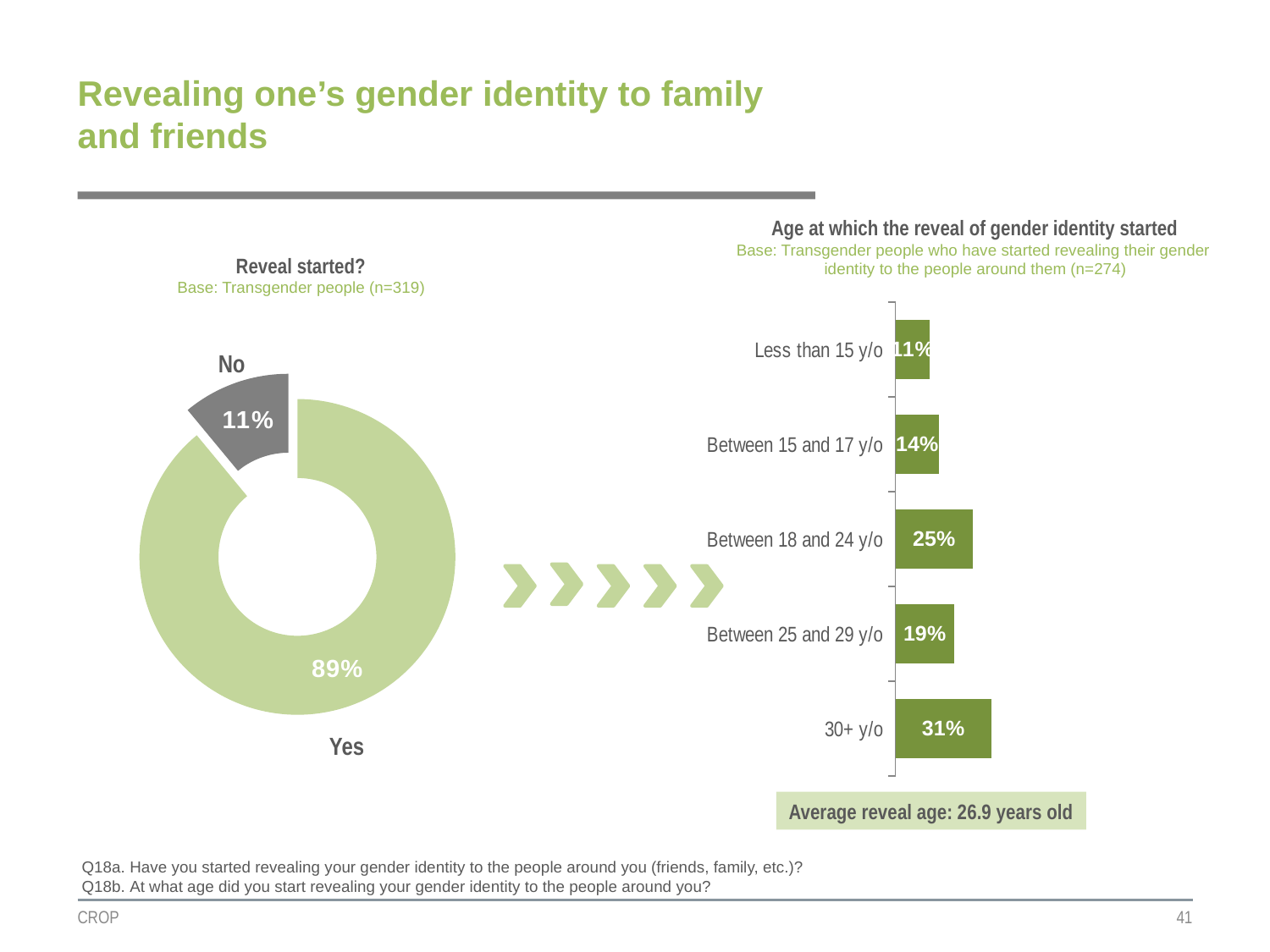
In the 'Age at which the reveal of gender identity started' chart, what is the value for Between 18 and 24 y/o? 25% In the 'Reveal started?' chart, how many categories are shown? 2 In the 'Age at which the reveal of gender identity started' chart, which age group has the highest value? 30+ y/o In the 'Reveal started?' chart, what percentage answered No? 11% In the 'Age at which the reveal of gender identity started' chart, what is the value for 30+ y/o? 31% In the 'Age at which the reveal of gender identity started' chart, which is larger: Between 18 and 24 y/o or Between 15 and 17 y/o? Between 18 and 24 y/o In the 'Age at which the reveal of gender identity started' chart, what is the difference between the values for 30+ y/o and Between 25 and 29 y/o? 12% In the 'Age at which the reveal of gender identity started' chart, which age group has the lowest value? Less than 15 y/o What kind of chart is the 'Age at which the reveal of gender identity started' chart? Bar chart What kind of chart is the 'Reveal started?' chart? Doughnut chart In the 'Reveal started?' chart, what percentage answered Yes? 89% In the 'Age at which the reveal of gender identity started' chart, how many age groups are shown? 5